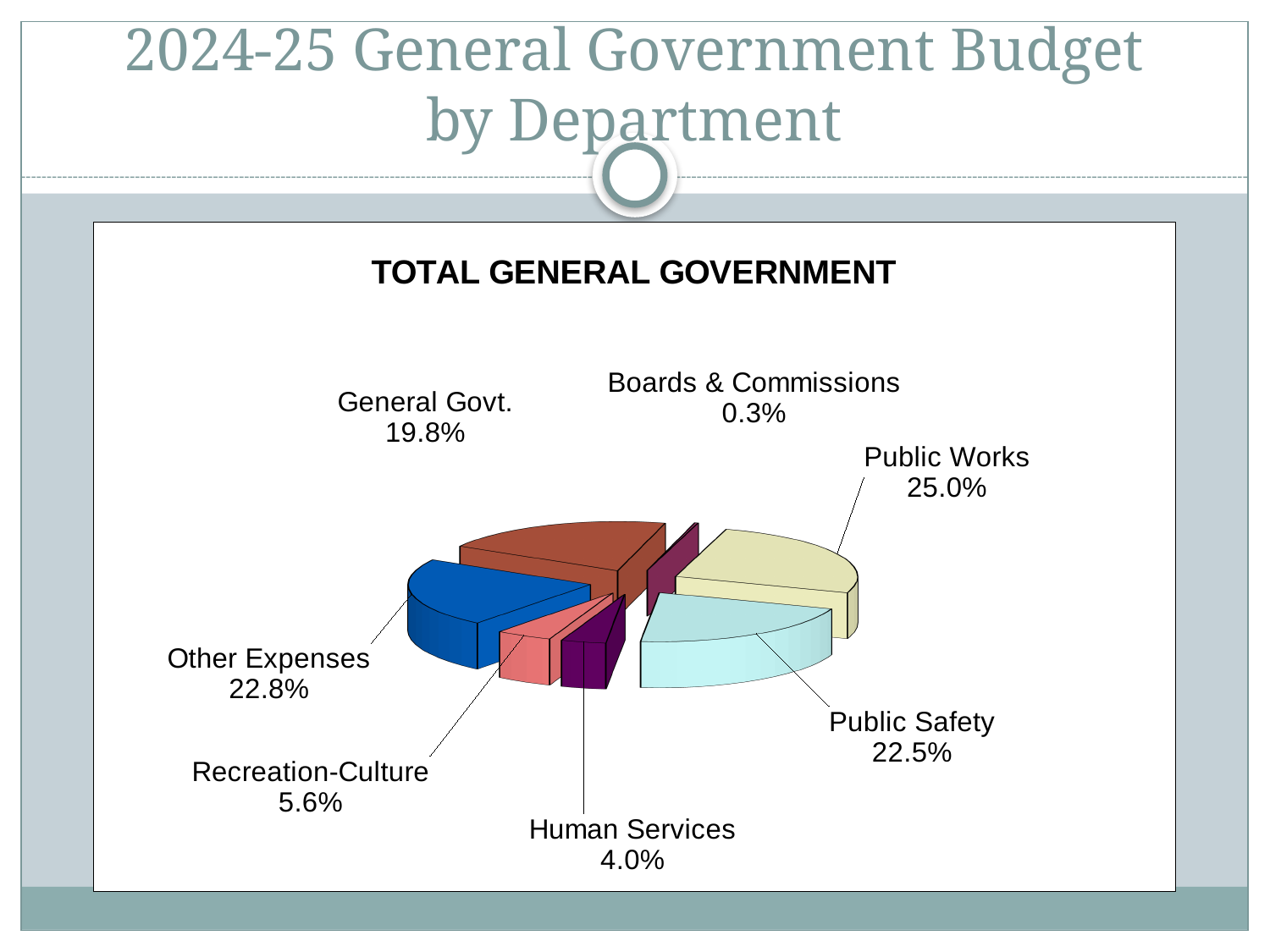
What percentage of the budget is allocated to Recreation-Culture? 5.6% Which category has the smallest share of the budget? Boards & Commissions What is the difference in percentage points between Other Expenses and Public Safety? 0.3 Which has a larger share, General Govt. or Public Safety? Public Safety What is the difference in percentage points between Public Works and General Govt.? 5.2 What percentage is shown for Other Expenses? 22.8% What is the share for Human Services? 4.0% How many categories are shown in the pie chart? 7 What is the title of the chart? TOTAL GENERAL GOVERNMENT What type of chart is shown on the slide? Pie chart What share of the total general government budget goes to Public Works? 25.0% Which department has the largest share of the budget? Public Works